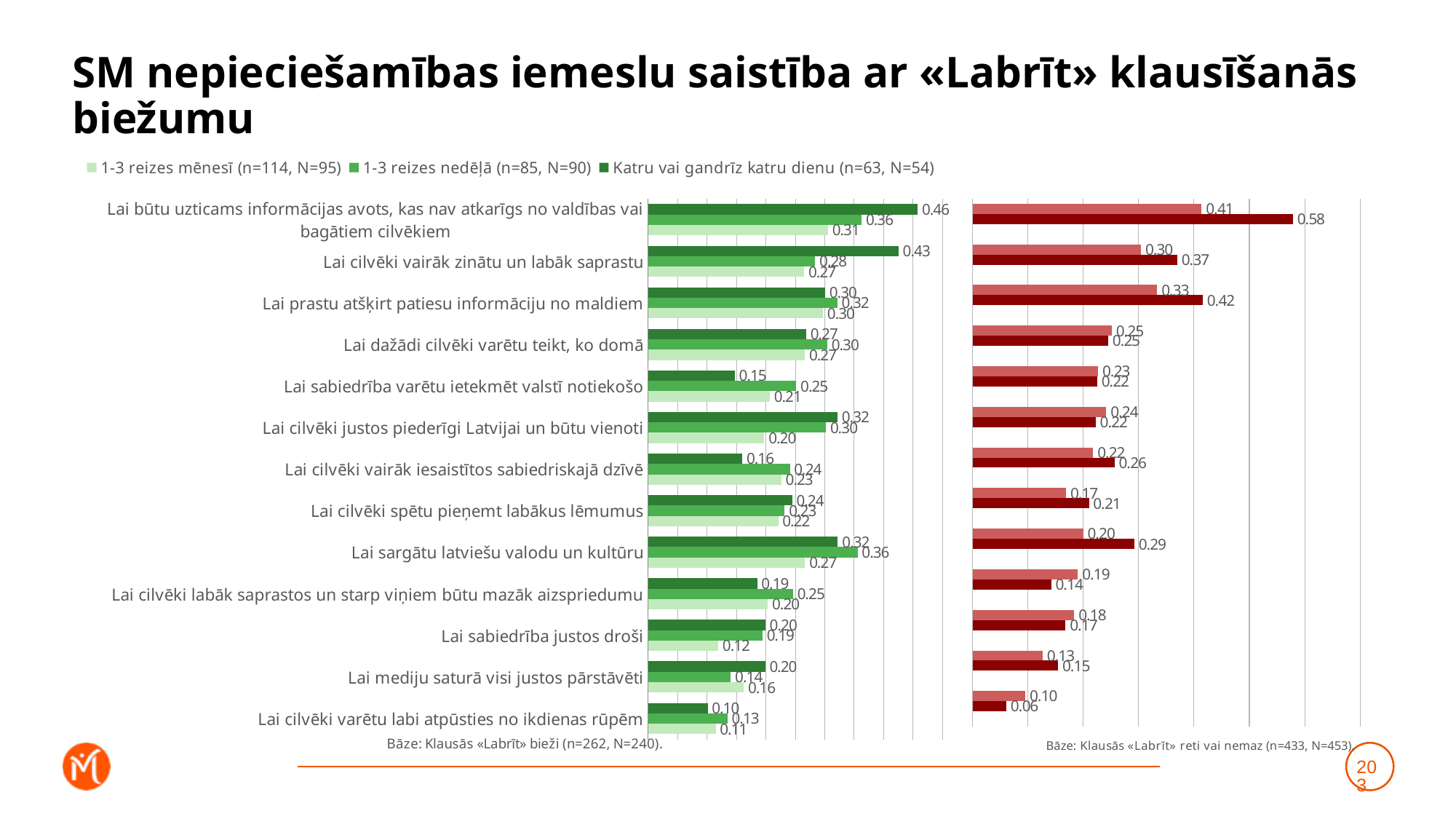
On the left (green) chart, what is the value for '1-3 reizes mēnesī' for 'Lai sabiedrība justos droši'? 0.12 How many categories (reasons) are listed on the left (green) chart? 13 On the left (green) chart, for 'Lai sabiedrība varētu ietekmēt valstī notiekošo', which is larger: the '1-3 reizes nedēļā' value or the 'Katru vai gandrīz katru dienu' value? 1-3 reizes nedēļā On the right (red) chart, which category has the lowest dark red bar value? Lai cilvēki varētu labi atpūsties no ikdienas rūpēm On the left (green) chart, what is the difference between the 'Katru vai gandrīz katru dienu' and '1-3 reizes mēnesī' values for 'Lai cilvēki vairāk zinātu un labāk saprastu'? 0.16 What type of chart is the left (green) chart? Bar chart On the right (red) chart, what is the value of the light red bar for 'Lai cilvēki varētu labi atpūsties no ikdienas rūpēm'? 0.10 On the left (green) chart, what is the value for '1-3 reizes nedēļā' for 'Lai sargātu latviešu valodu un kultūru'? 0.36 How many series does the legend above the left (green) chart list? 3 On the left (green) chart, which category has the highest value for 'Katru vai gandrīz katru dienu'? Lai būtu uzticams informācijas avots, kas nav atkarīgs no valdības vai bagātiem cilvēkiem On the right (red) chart, what is the value of the dark red bar for 'Lai būtu uzticams informācijas avots, kas nav atkarīgs no valdības vai bagātiem cilvēkiem'? 0.58 On the left (green) chart, what is the value for 'Katru vai gandrīz katru dienu' for 'Lai būtu uzticams informācijas avots, kas nav atkarīgs no valdības vai bagātiem cilvēkiem'? 0.46